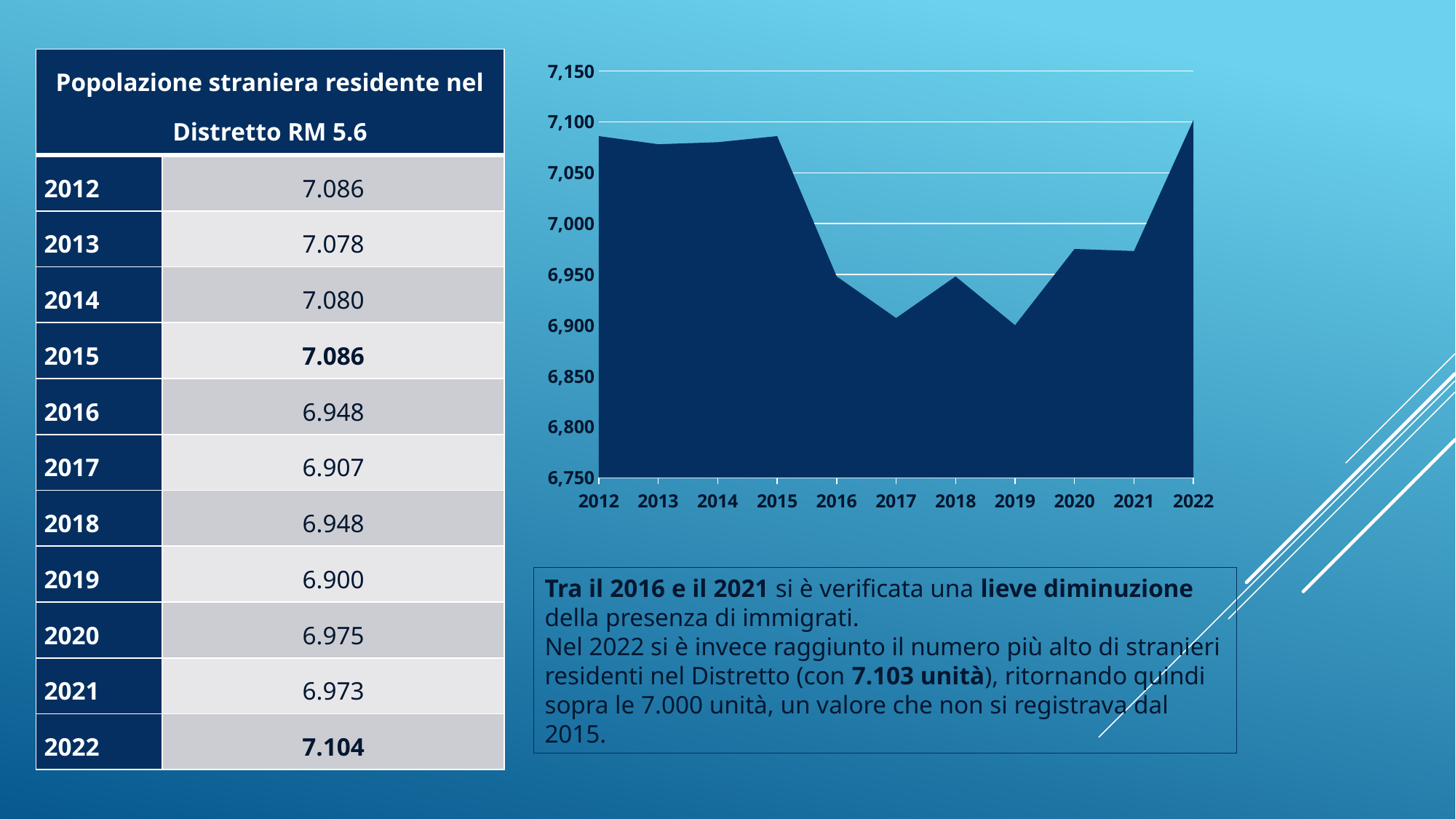
What kind of chart is shown on the right of the slide? area chart Do the values rise or fall from 2015 to 2017? fall Is the value for 2012 greater or less than 7,050? greater Which is larger, the value for 2016 or the value for 2017? 2016 How many years are plotted along the x axis of the chart? 11 Do the values rise or fall from 2019 to 2022? rise Is the value for 2016 greater or less than 7,000? less Which year has the highest value in the chart? 2022 Is the value for 2019 greater or less than 6,950? less Which is larger, the value for 2015 or the value for 2016? 2015